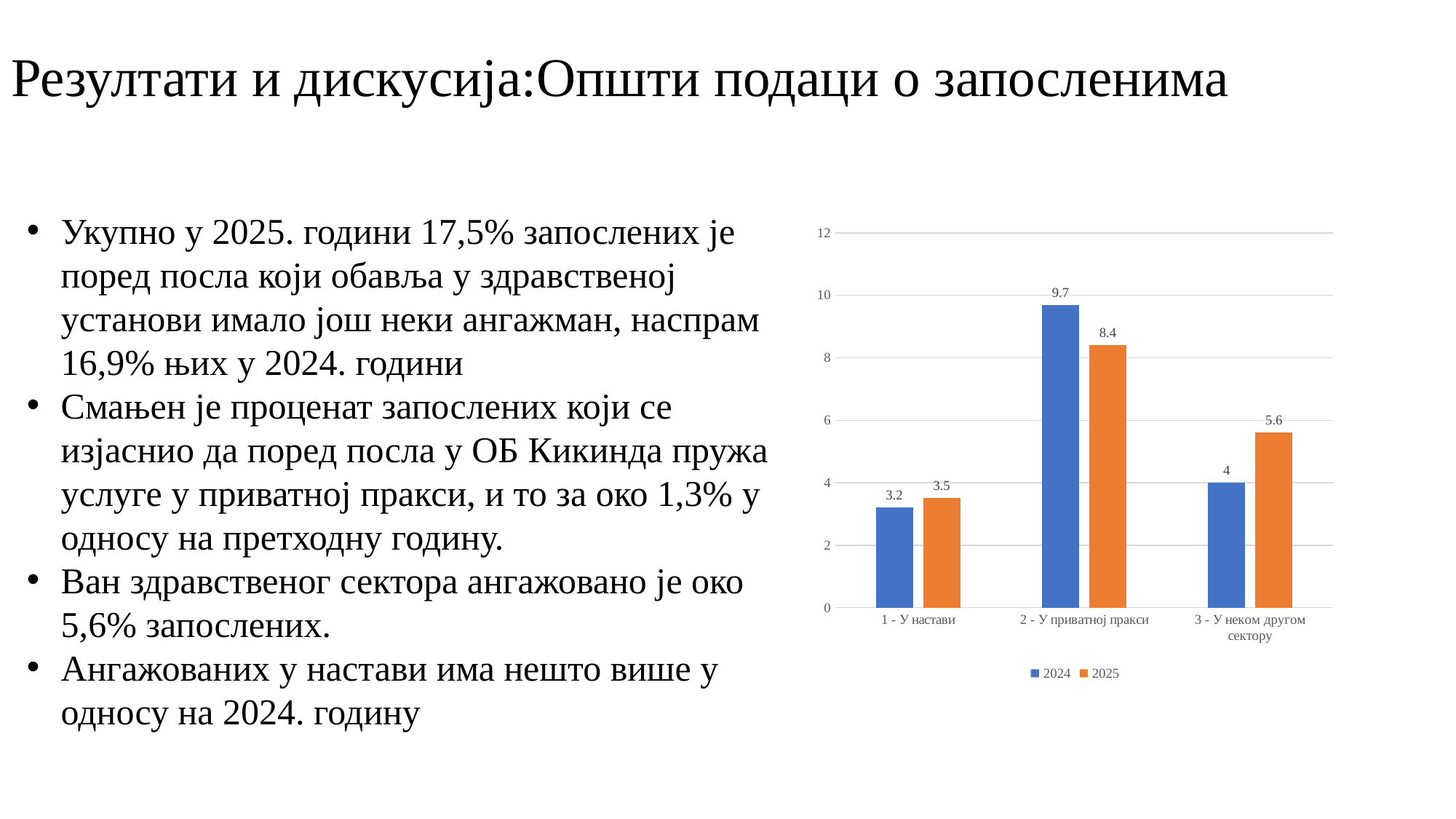
Which category has the highest 2025 value? 2 - У приватној пракси What is the 2025 value for '3 - У неком другом сектору'? 5.6 How many categories are shown on the x axis? 3 What is the 2025 value for '1 - У настави'? 3.5 What is the 2024 value for '1 - У настави'? 3.2 What kind of chart is shown on the slide? Bar chart Which category has the lowest 2024 value? 1 - У настави What is the 2024 value for '2 - У приватној пракси'? 9.7 How many series does the legend list? 2 What is the difference between the 2024 and 2025 values for '2 - У приватној пракси'? 1.3 For '3 - У неком другом сектору', which series has the larger value, 2024 or 2025? 2025 Which colour represents the 2025 series in the chart? Orange